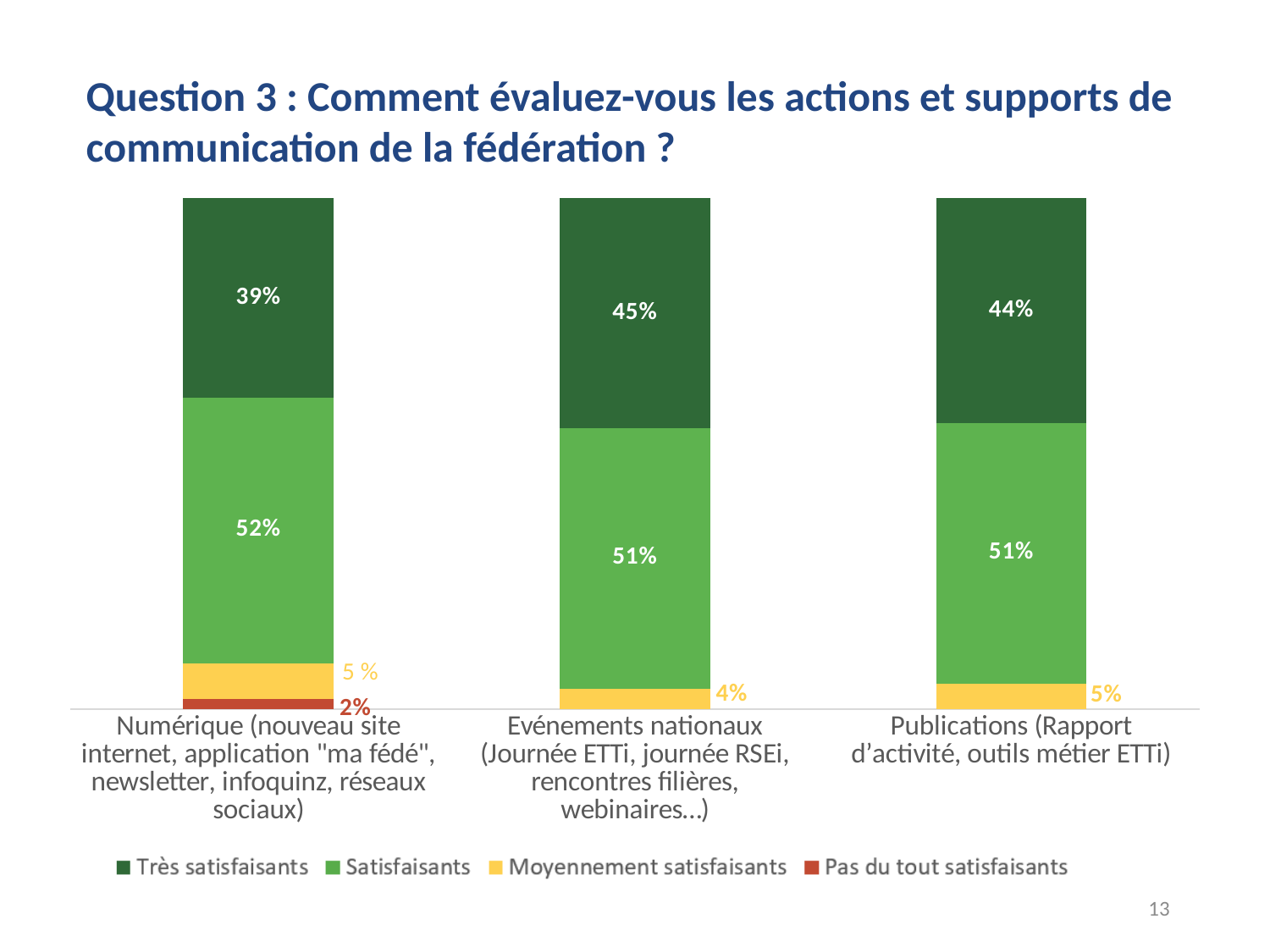
Which category has the lowest "Très satisfaisants" value? Numérique How many categories are shown on the x axis of the chart? 3 What is the "Satisfaisants" value for Numérique? 52% Which category has the highest "Très satisfaisants" value? Evénements nationaux What kind of chart is shown on the slide? Stacked bar chart Which is larger: the "Moyennement satisfaisants" value for Publications or for Evénements nationaux? Publications How many series does the legend list? 4 Which series is shown in dark green in the legend? Très satisfaisants What is the "Moyennement satisfaisants" value for Publications? 5% What is the difference between the "Très satisfaisants" values for Evénements nationaux and Numérique? 6% What is the "Très satisfaisants" value for Evénements nationaux? 45% What is the "Pas du tout satisfaisants" value for Numérique? 2%